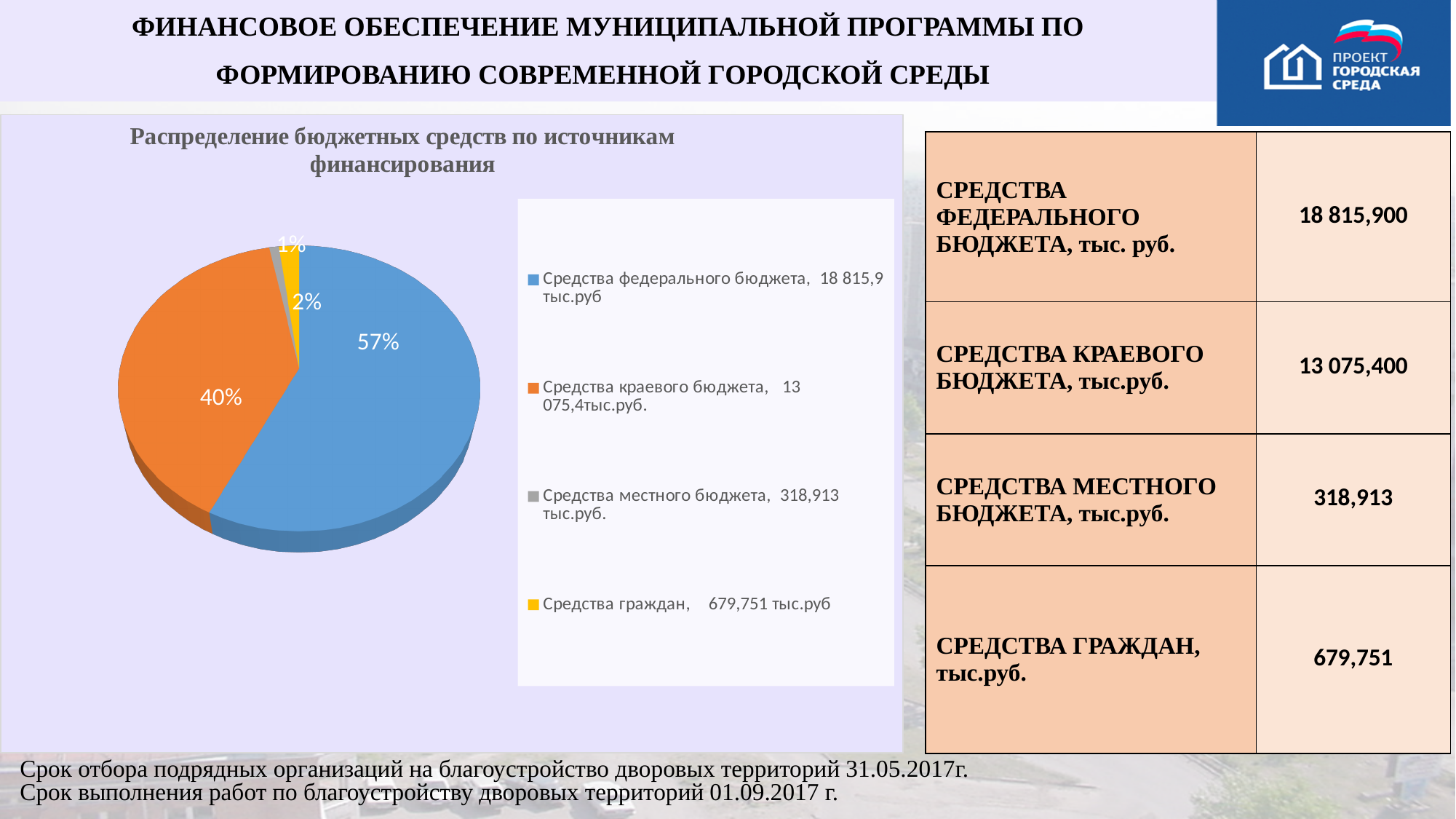
By how many percentage points does the federal budget share exceed the regional (краевого) budget share? 17 Which funding source has the largest slice of the pie? Средства федерального бюджета According to the legend, what amount in тыс.руб is given for 'Средства граждан'? 679,751 What share of the pie does 'Средства краевого бюджета' represent? 40% Which is larger: the share for 'Средства краевого бюджета' or 'Средства граждан'? Средства краевого бюджета How many slices does the pie chart have? 4 What share of the pie does 'Средства федерального бюджета' represent? 57% Which funding source has the smallest slice of the pie? Средства местного бюджета What share of the pie does 'Средства граждан' represent? 2% What is the title of the pie chart? Распределение бюджетных средств по источникам финансирования What type of chart is shown on the slide? pie chart